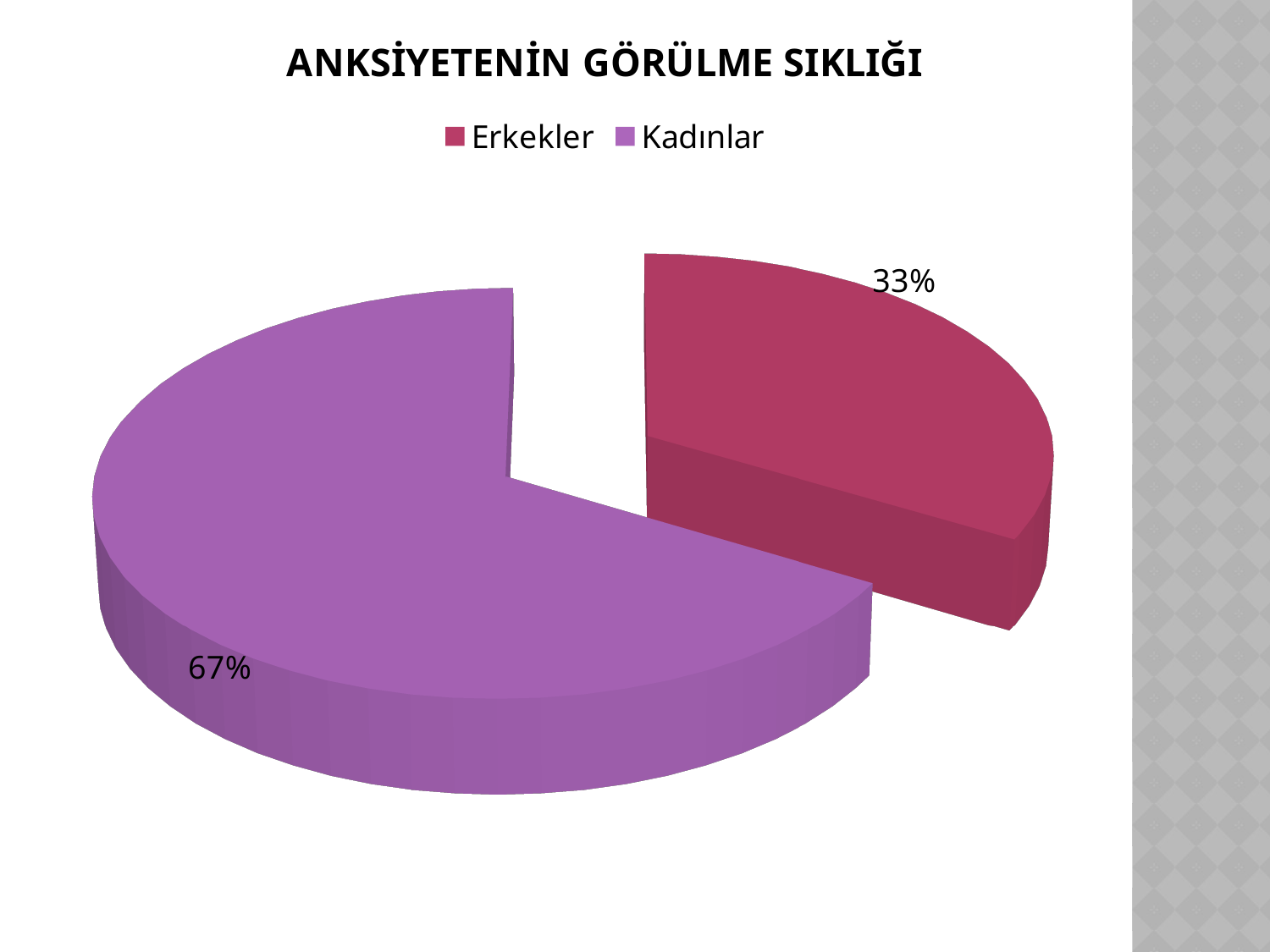
Which category has the smallest slice of the pie? Erkekler What kind of chart is shown on the slide? Pie chart What colour is the Erkekler slice? Red Which slice is larger, Erkekler or Kadınlar? Kadınlar How many entries does the legend list? 2 What is the difference in percentage points between the Kadınlar and Erkekler slices? 34% How many slices does the pie chart have? 2 What share of the pie does Kadınlar represent? 67% Is the value for Kadınlar greater or less than 50%? greater What share of the pie does Erkekler represent? 33% Which category has the largest slice of the pie? Kadınlar What is the title of the chart? ANKSİYETENİN GÖRÜLME SIKLIĞI